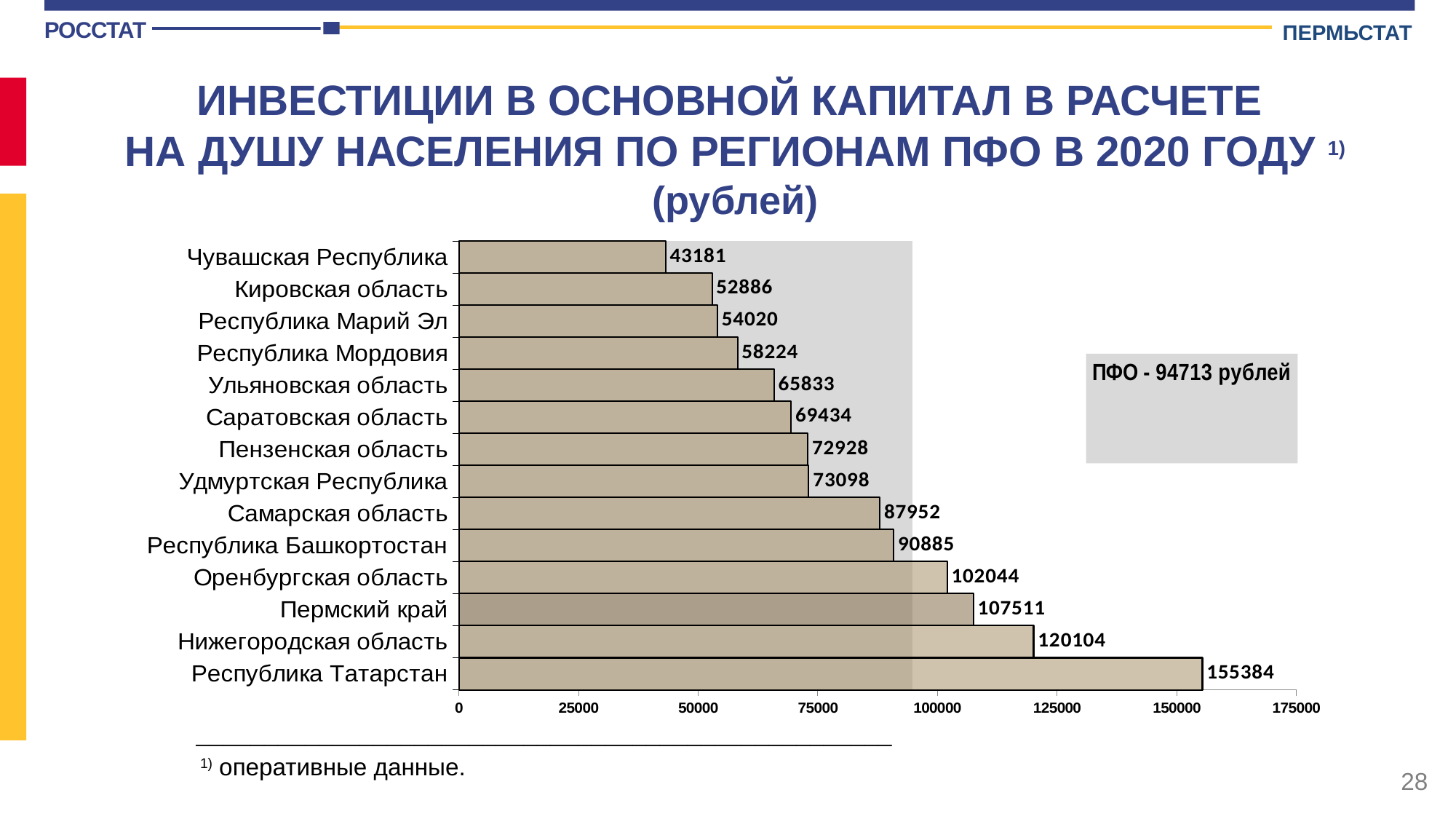
How many regions are shown in the chart? 14 Is the value for Самарская область greater or less than 100000? less Which is larger, the value for Оренбургская область or the value for Республика Башкортостан? Оренбургская область What value for ПФО is shown in the box on the chart? 94713 рублей What is the difference between the values for Нижегородская область and Пермский край? 12593 What is the value for Республика Мордовия? 58224 Which region has the highest value? Республика Татарстан What is the difference between the values for Республика Татарстан and Пермский край? 47873 What is the value for Самарская область? 87952 What kind of chart is shown on the slide? bar chart Which region has the lowest value? Чувашская Республика What is the value for Пермский край? 107511